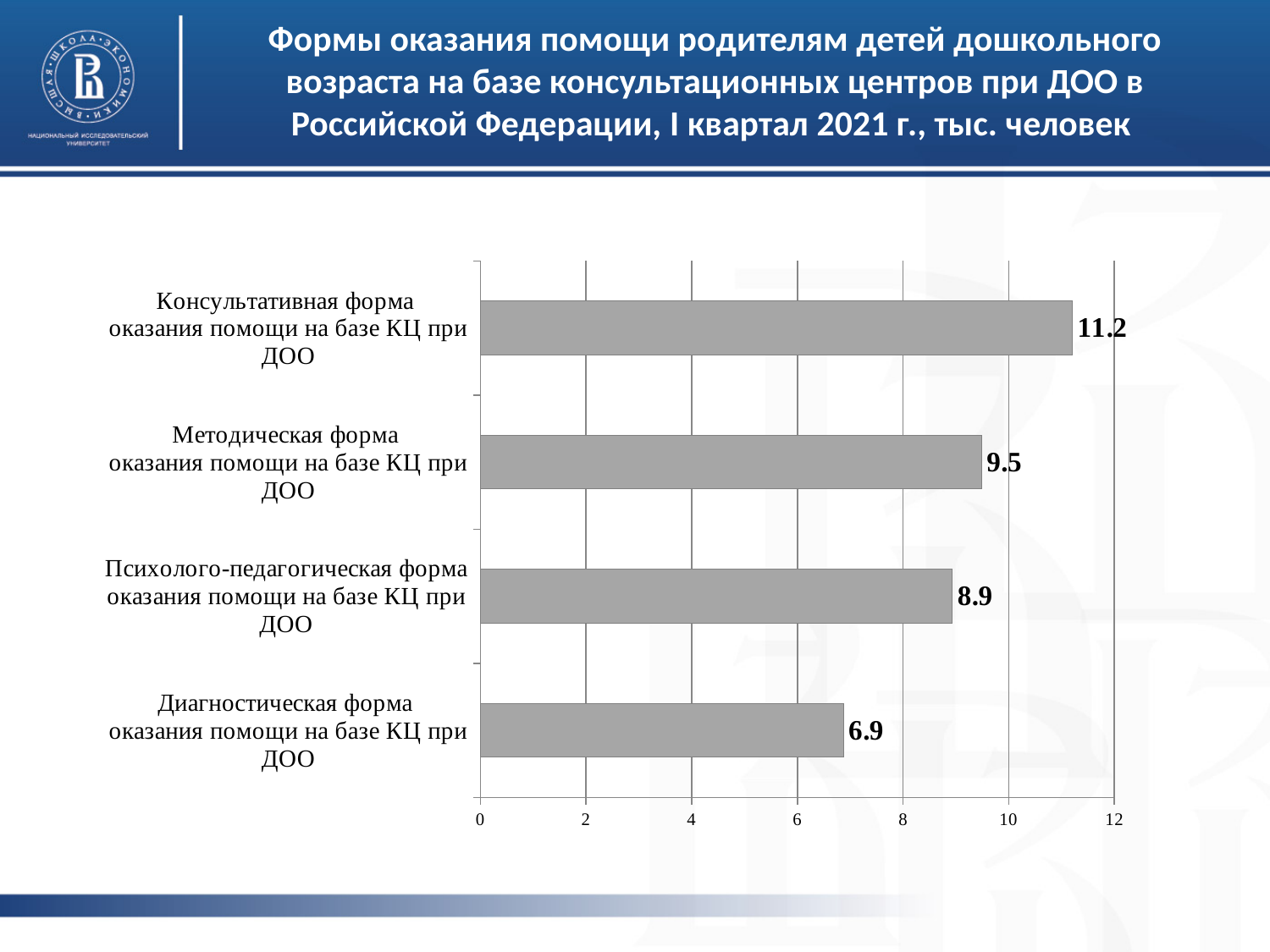
What is the value for Консультативная форма оказания помощи на базе КЦ при ДОО? 11.2 Which form of assistance has the highest value? Консультативная форма оказания помощи на базе КЦ при ДОО How many categories are shown in the chart? 4 What kind of chart is shown on the slide? bar chart What is the difference between the values for Методическая форма and Психолого-педагогическая форма? 0.6 Which form of assistance has the lowest value? Диагностическая форма оказания помощи на базе КЦ при ДОО What is the value for Методическая форма оказания помощи на базе КЦ при ДОО? 9.5 What is the value for Диагностическая форма оказания помощи на базе КЦ при ДОО? 6.9 Is the value for Консультативная форма greater or less than 10? greater What is the value for Психолого-педагогическая форма оказания помощи на базе КЦ при ДОО? 8.9 What is the difference between the values for Консультативная форма and Диагностическая форма? 4.3 Which is larger: the value for Методическая форма or Психолого-педагогическая форма? Методическая форма оказания помощи на базе КЦ при ДОО